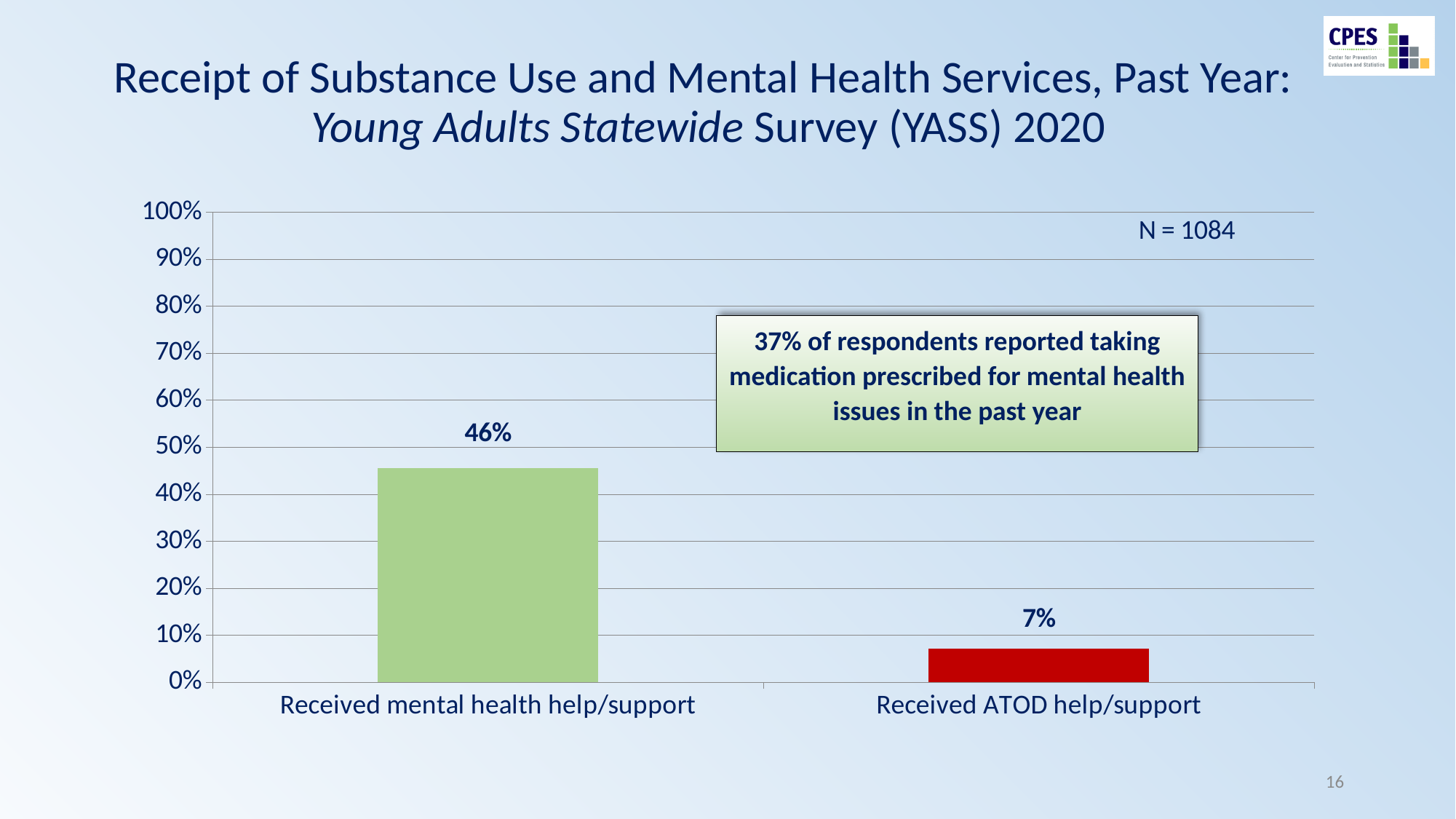
Which category has the highest value? Received mental health help/support Which is larger: the value for received mental health help/support or the value for received ATOD help/support? Received mental health help/support Is the value for received mental health help/support greater or less than 50%? less What kind of chart is shown on the slide? Bar chart Is the value for received ATOD help/support greater or less than 10%? less Which category has the lowest value? Received ATOD help/support What percentage of respondents received ATOD help/support? 7% What is the sample size (N) shown on the chart? N = 1084 What percentage of respondents received mental health help/support? 46% According to the text box on the chart, what percentage of respondents reported taking medication prescribed for mental health issues in the past year? 37% How many categories are shown in the chart? 2 What is the difference in percentage points between receiving mental health help/support and receiving ATOD help/support? 39 percentage points